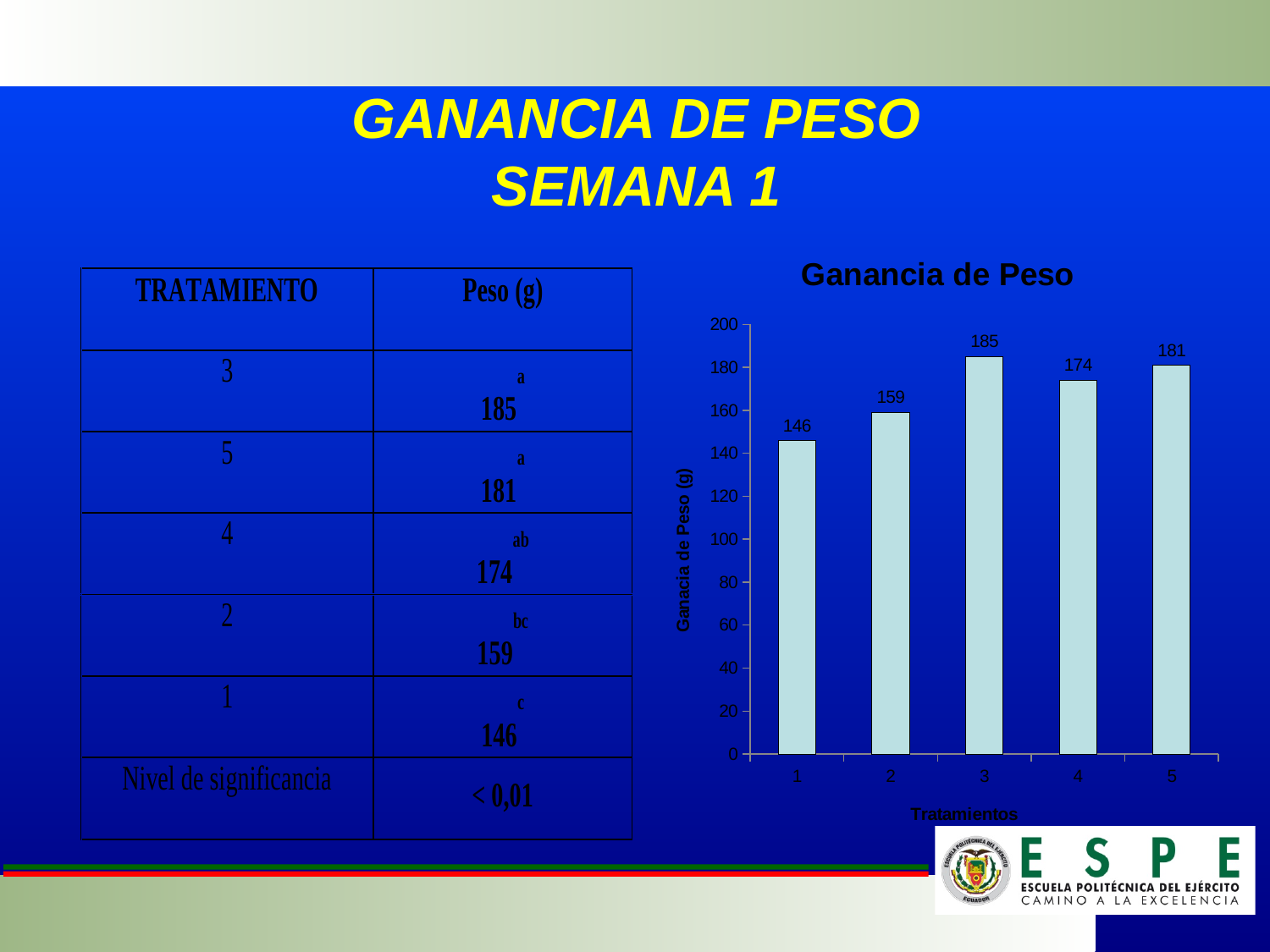
What is the value for treatment 3 in the Ganancia de Peso chart? 185 What is the value for treatment 5 in the Ganancia de Peso chart? 181 What is the difference between the values for treatment 4 and treatment 2? 15 Which treatment has the highest weight gain in the chart? 3 What kind of chart is shown on the slide? bar chart What is the title of the chart on the slide? Ganancia de Peso What is the value for treatment 1 in the Ganancia de Peso chart? 146 Which is larger, the value for treatment 2 or the value for treatment 4? treatment 4 What is the difference between the values for treatment 3 and treatment 1? 39 How many treatments are plotted in the chart? 5 Which treatment has the lowest weight gain in the chart? 1 Is the value for treatment 2 greater or less than 140? greater